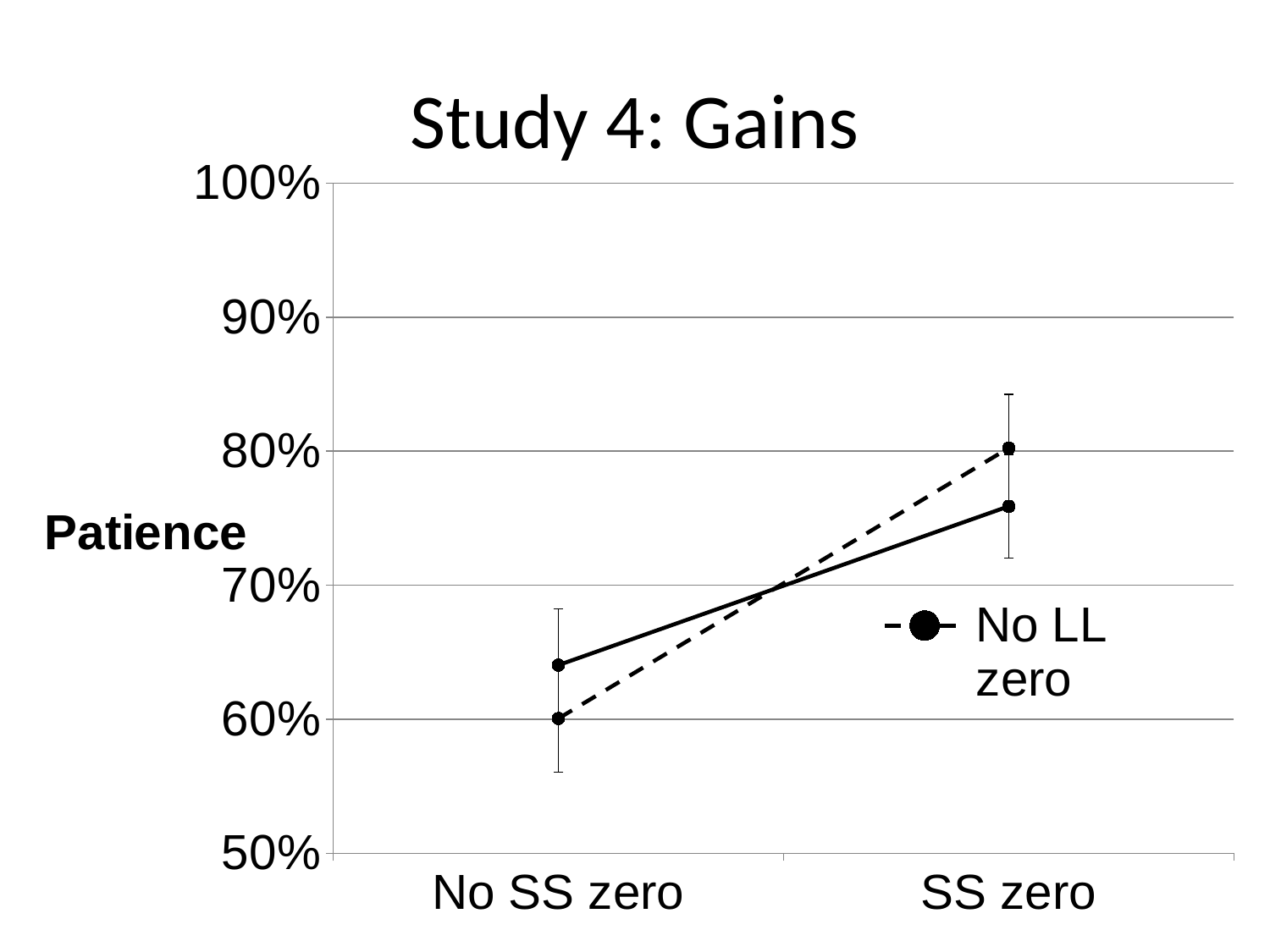
How many categories are shown on the x axis? 2 Does the No LL zero series rise or fall from No SS zero to SS zero? rise Is the value of the solid line at No SS zero greater or less than 70%? less How many series does the legend list? 1 At SS zero, which is higher: the dashed No LL zero line or the solid line? the dashed No LL zero line Is the value of the solid line at SS zero greater or less than 70%? greater What kind of chart is shown on the slide? line chart What is the title of the chart? Study 4: Gains What is the label on the vertical axis of the chart? Patience